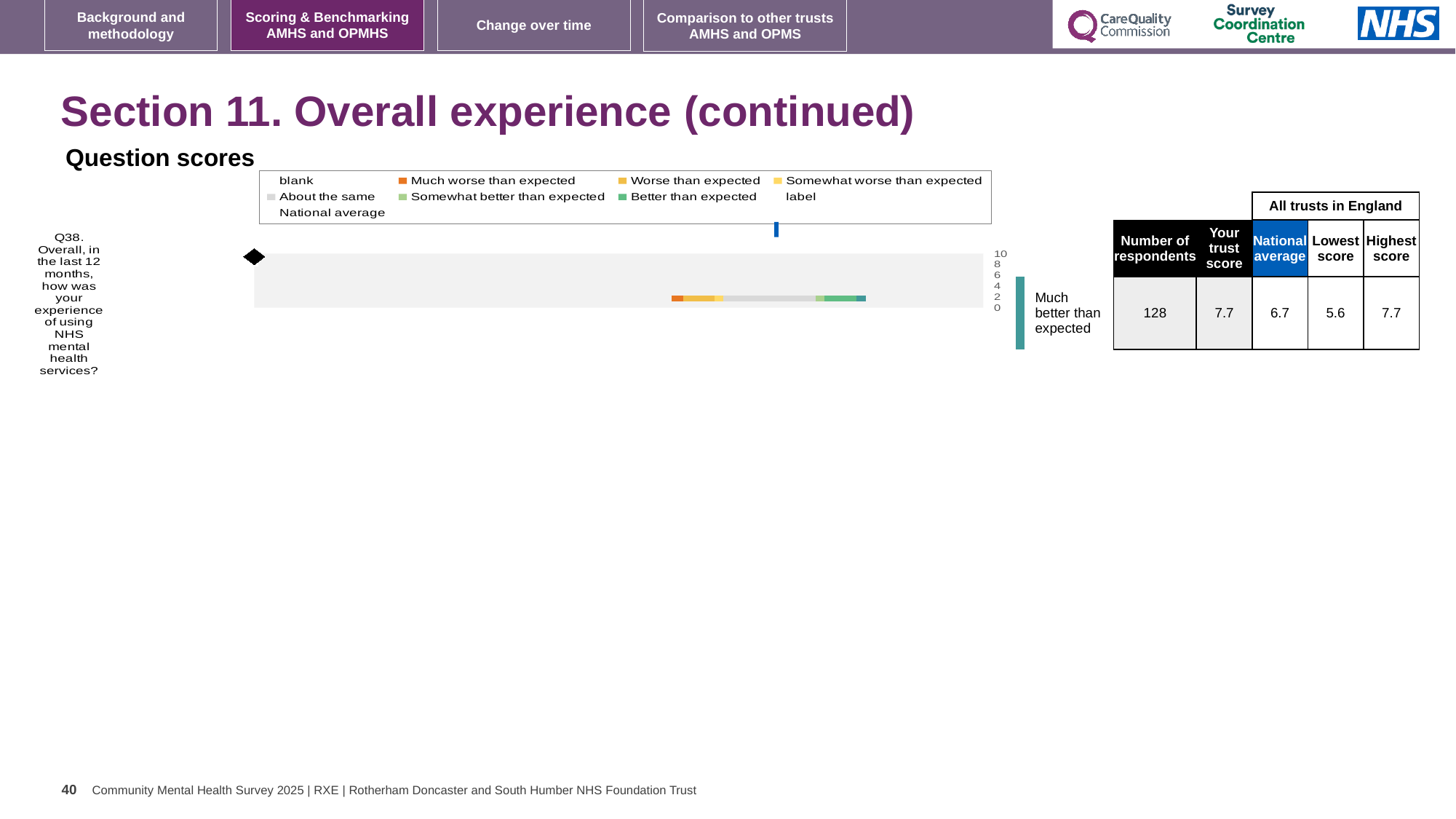
According to the table next to the chart, what is the national average score for Q38? 6.7 Which is larger for Q38: the trust's score or the national average? The trust's score What kind of chart is shown on the slide? Stacked bar chart Which question is plotted in the chart? Q38. Overall, in the last 12 months, how was your experience of using NHS mental health services? According to the table next to the chart, what is the highest score among all trusts in England for Q38? 7.7 How many question categories are plotted in the chart? 1 How many respondents answered Q38, according to the table next to the chart? 128 According to the table next to the chart, what is the lowest score among all trusts in England for Q38? 5.6 What is the difference between the highest and lowest scores among all trusts in England for Q38? 2.1 What is the highest value shown on the chart's axis? 10 What is the difference between the trust's score and the national average for Q38? 1.0 According to the table next to the chart, what is the trust's score for Q38? 7.7